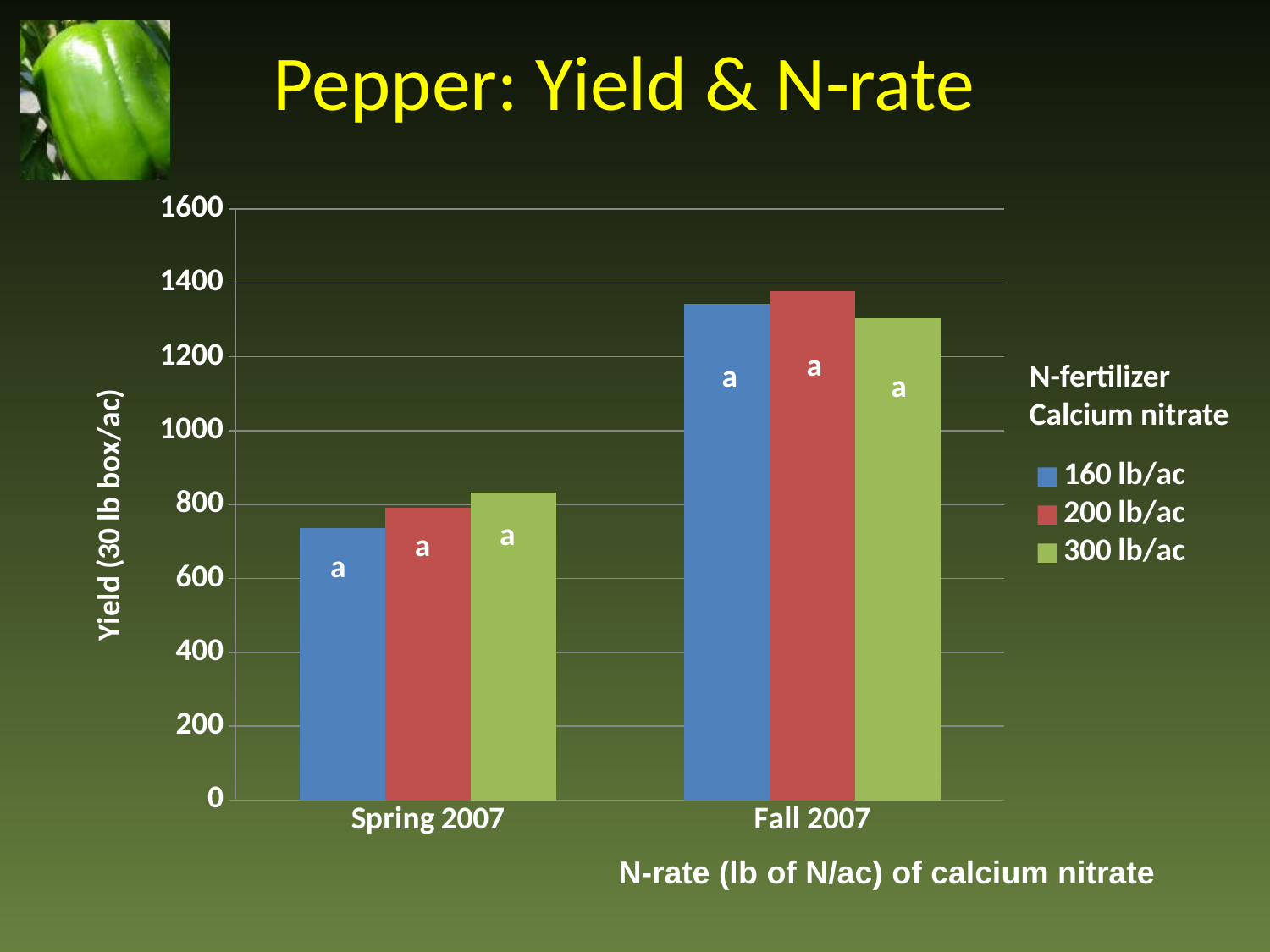
Which N-rate has the lowest yield in Spring 2007? 160 lb/ac Is the yield for 300 lb/ac in Spring 2007 greater or less than 800? greater Which N-rate has the highest yield in Spring 2007? 300 lb/ac Is the yield for 300 lb/ac in Fall 2007 greater or less than 1400? less How many categories are shown on the x axis? 2 How many series does the legend list? 3 What kind of chart is shown on the slide? bar chart Is the yield for 200 lb/ac in Fall 2007 greater or less than 1200? greater Which is larger, the yield for 160 lb/ac in Spring 2007 or in Fall 2007? Fall 2007 Which is larger in Fall 2007, the yield for 200 lb/ac or for 300 lb/ac? 200 lb/ac What is the label of the y axis? Yield (30 lb box/ac)